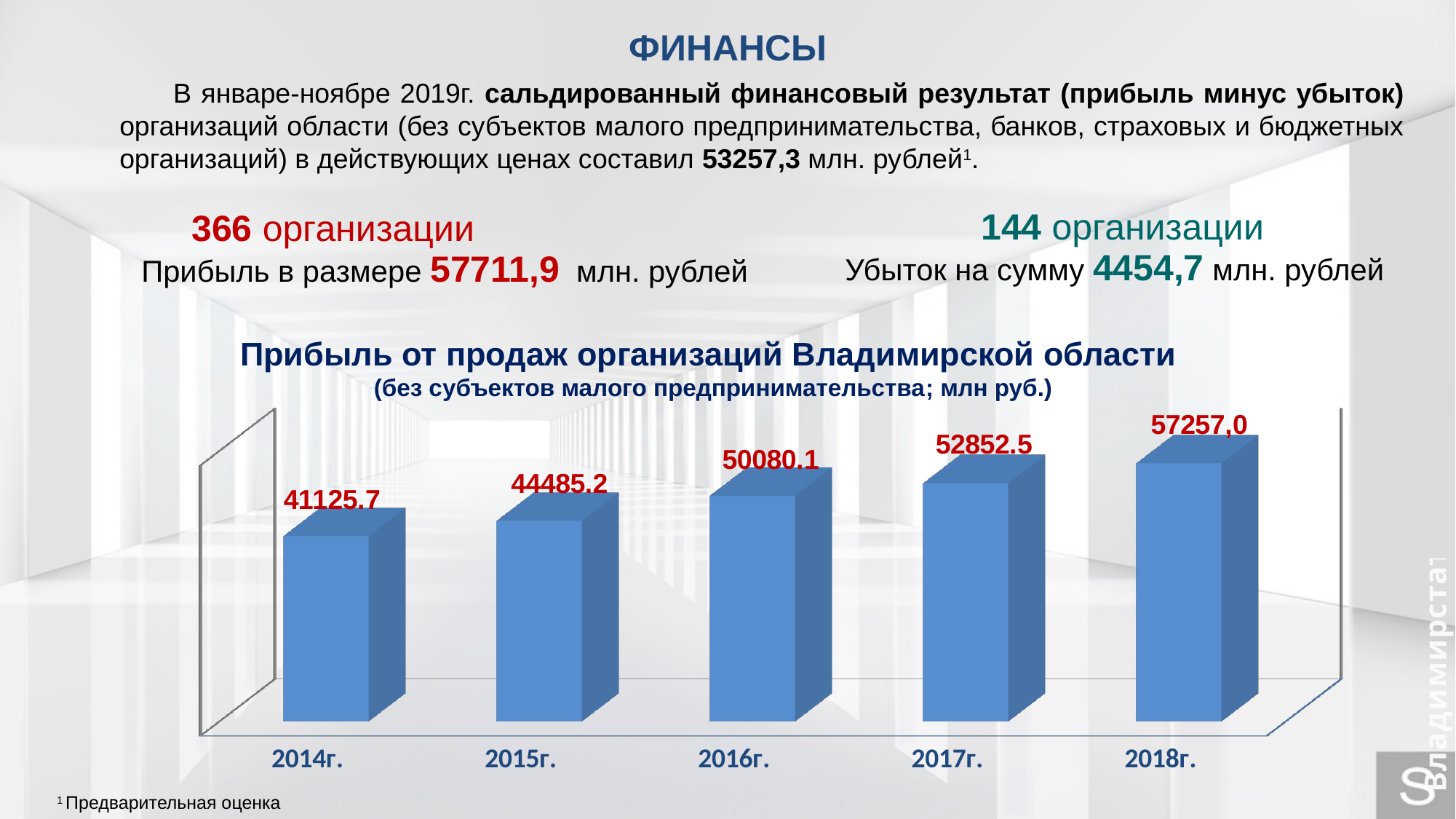
How many years are shown in the chart? 5 What kind of chart is shown on the slide? bar chart What is the value for 2014г. in the chart 'Прибыль от продаж организаций Владимирской области'? 41125.7 What is the difference between the values for 2015г. and 2014г.? 3359.5 What unit is stated in the chart's subtitle? млн руб. Do the values rise or fall from 2014г. to 2018г.? rise What is the value for 2018г. in the chart? 57257,0 Which year has the highest value in the chart? 2018г. Which year has the lowest value in the chart? 2014г. What is the difference between the values for 2018г. and 2017г.? 4404.5 What is the value for 2016г. in the chart? 50080.1 Which is larger, the value for 2016г. or the value for 2015г.? 2016г.